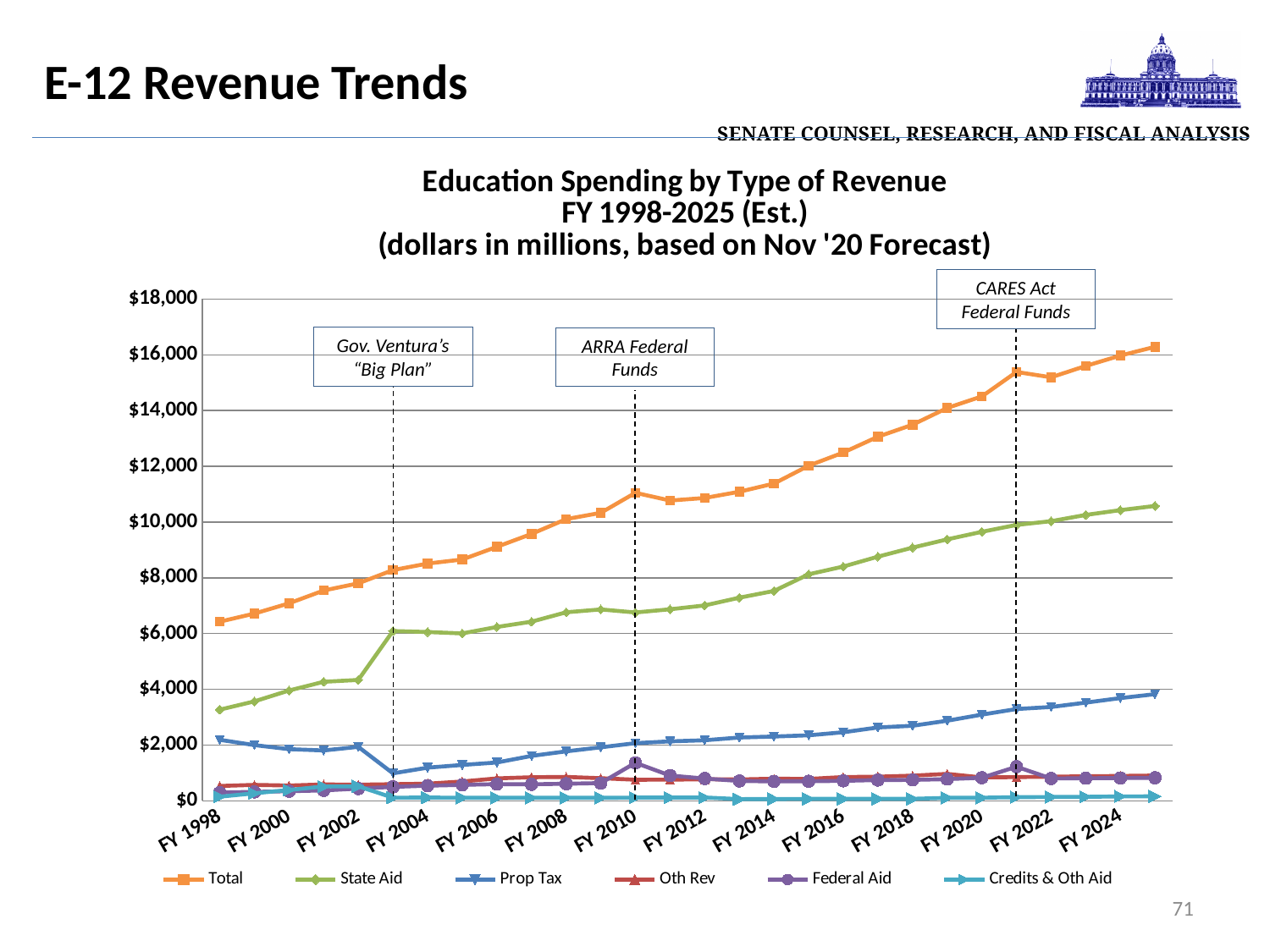
Is the State Aid value for FY 2018 greater or less than $8,000? greater Is the Prop Tax value for FY 2024 greater or less than $4,000? less How many fiscal years does the chart cover, according to its title? 28 (FY 1998-2025) In FY 2024, which is larger: Prop Tax or Federal Aid? Prop Tax Does the Total series generally rise or fall from FY 1998 to FY 2025? Rise Is the Total value for FY 2010 greater or less than $10,000? greater What event is annotated with a dashed line at FY 2010? ARRA Federal Funds How many series does the legend list? 6 What kind of chart is shown on the slide? Line chart Which series has the highest values throughout the chart? Total